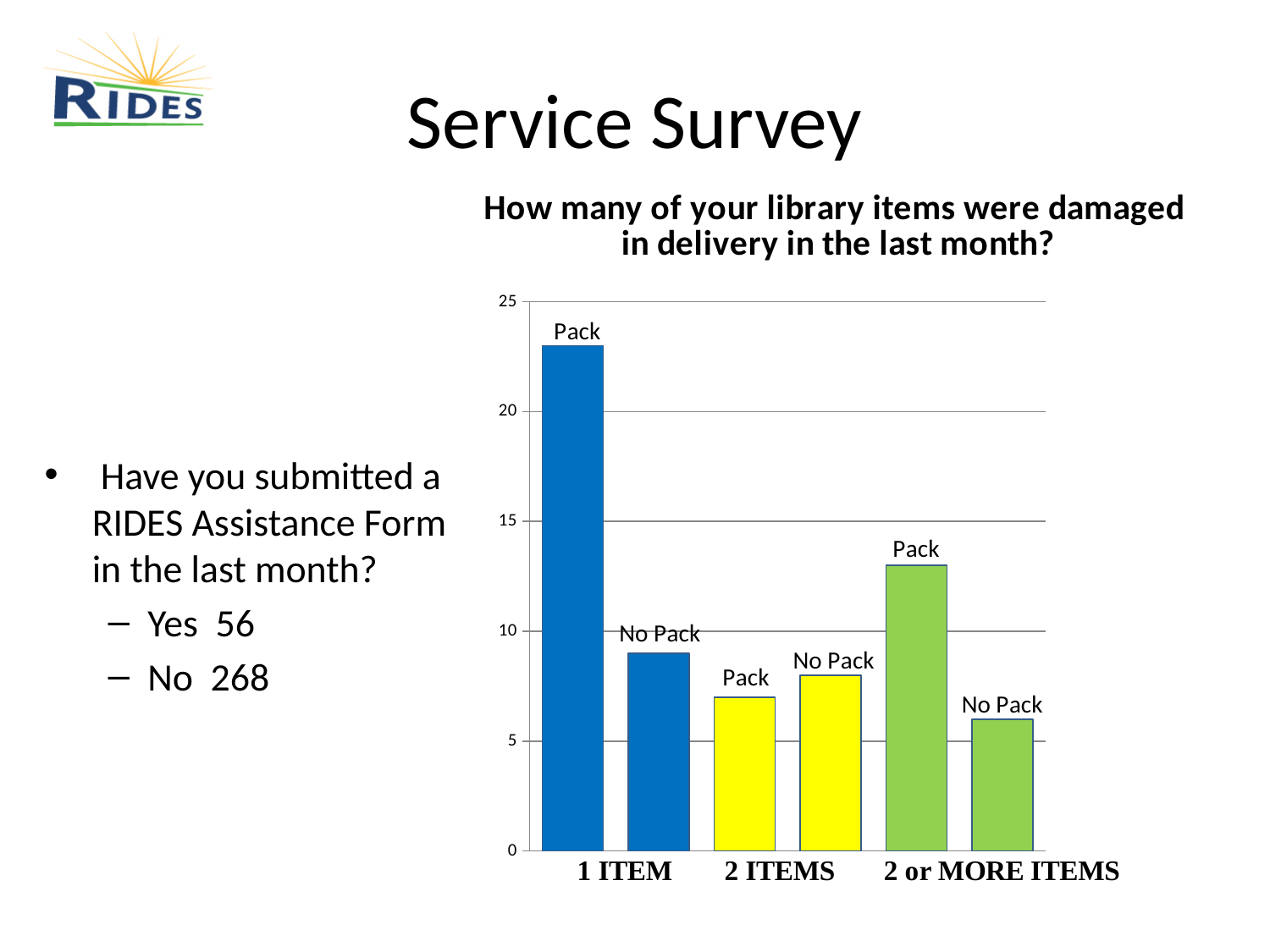
What kind of chart is shown on the slide? bar chart For 2 or MORE ITEMS, which bar is taller, Pack or No Pack? Pack For 1 ITEM, which bar is taller, Pack or No Pack? Pack Is the value of the No Pack bar for 2 or MORE ITEMS greater or less than 10? less Which category has the tallest Pack bar? 1 ITEM How many categories are shown on the x axis of the chart? 3 Is the value of the Pack bar for 1 ITEM greater or less than 20? greater What is the title of the chart? How many of your library items were damaged in delivery in the last month? Is the value of the Pack bar for 2 or MORE ITEMS greater or less than 10? greater Which bar in the chart is the tallest? Pack for 1 ITEM